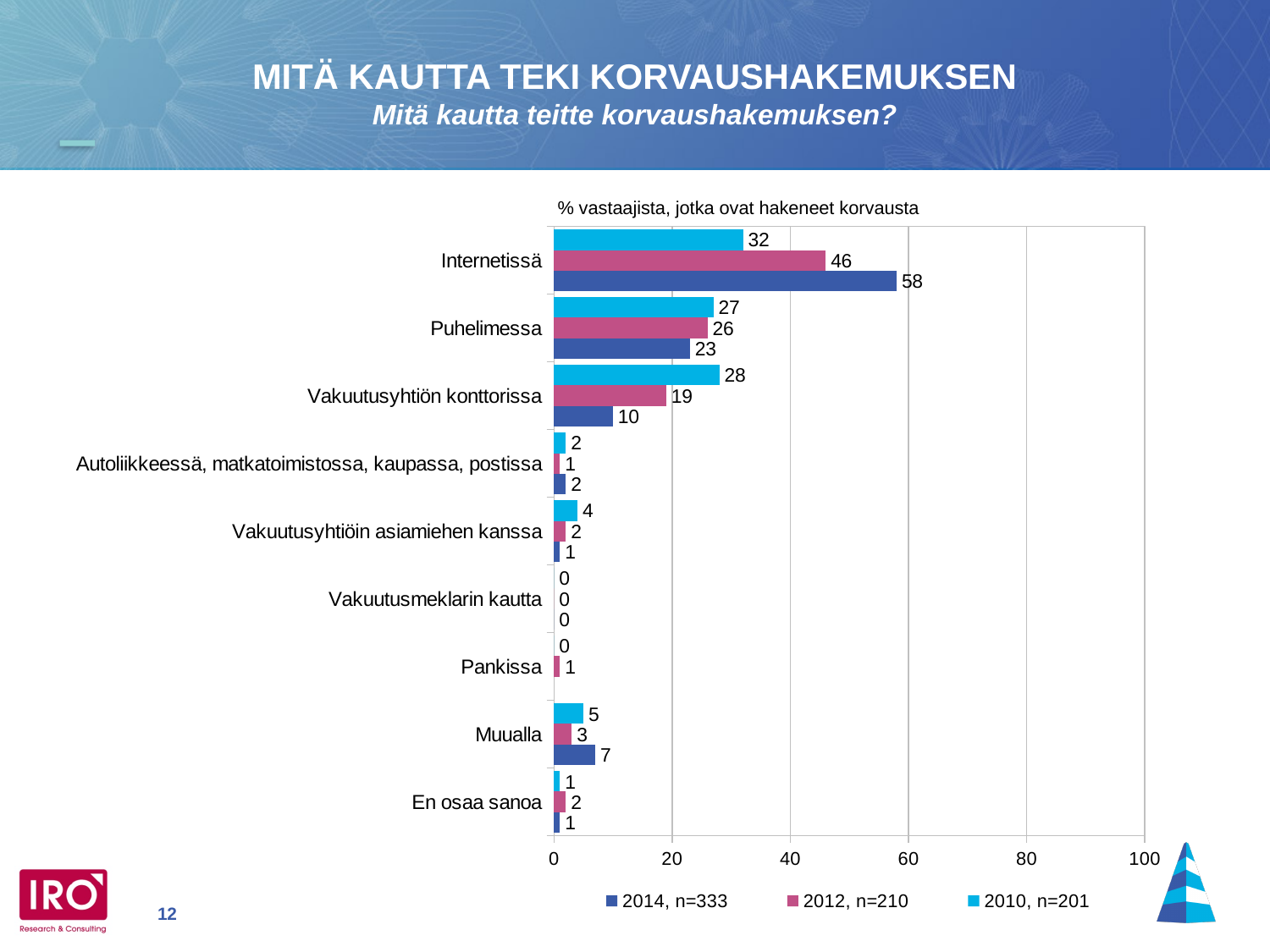
What is the value for Internetissä in the 2014, n=333 series? 58 How many series does the legend list? 3 Which category has the highest value in the 2014, n=333 series? Internetissä How many categories are shown on the chart? 9 What is the value for Puhelimessa in the 2012, n=210 series? 26 What is the axis title shown above the chart? % vastaajista, jotka ovat hakeneet korvausta What kind of chart is shown on the slide? bar chart Is the value for Internetissä in the 2012, n=210 series greater or less than 40? greater What is the value for Muualla in the 2014, n=333 series? 7 What is the difference between the 2014, n=333 and 2010, n=201 values for Internetissä? 26 Which is larger for Vakuutusyhtiön konttorissa: the 2012, n=210 value or the 2014, n=333 value? 2012, n=210 What is the value for Vakuutusyhtiön konttorissa in the 2010, n=201 series? 28